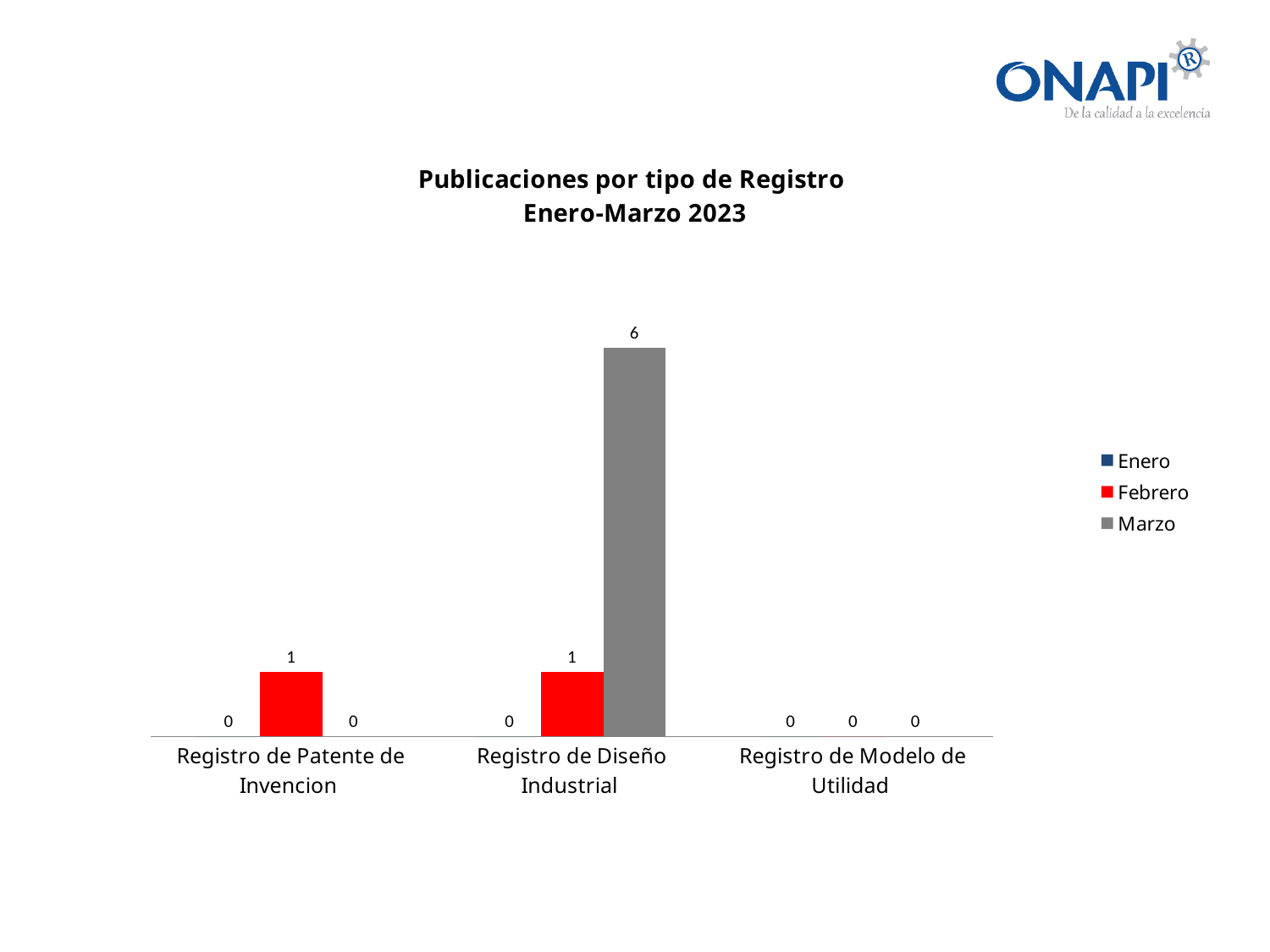
Which category has the highest value for Marzo? Registro de Diseño Industrial How many series does the legend list? 3 What is the value for Marzo in the Registro de Diseño Industrial category? 6 What is the value for Marzo in the Registro de Patente de Invencion category? 0 What is the value for Enero in the Registro de Modelo de Utilidad category? 0 What is the title of the chart? Publicaciones por tipo de Registro Enero-Marzo 2023 How many categories are shown on the x axis? 3 What colour represents the Febrero series? Red Which is larger for Registro de Diseño Industrial: the Febrero value or the Marzo value? Marzo What is the difference between the Marzo and Febrero values for Registro de Diseño Industrial? 5 What kind of chart is shown on the slide? Bar chart What is the value for Febrero in the Registro de Patente de Invencion category? 1